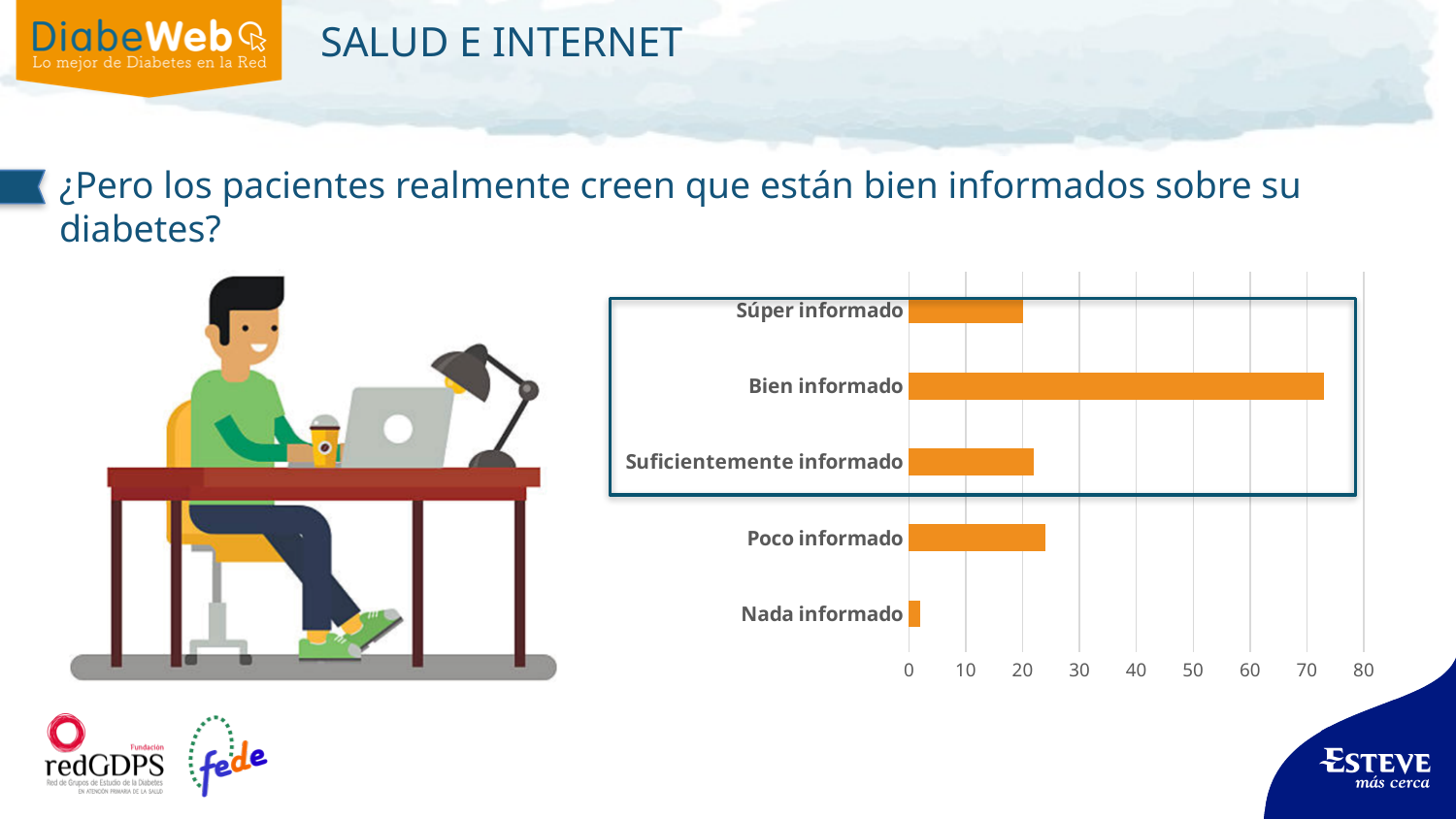
Is the value for Poco informado greater or less than 20? greater Is the value for Suficientemente informado greater or less than 30? less Which category has the lowest value in the chart? Nada informado How many categories are plotted in the chart? 5 Which category has the highest value in the chart? Bien informado Which is larger, the value for Súper informado or the value for Nada informado? Súper informado Which is larger, the value for Bien informado or the value for Poco informado? Bien informado What colour are the bars in the chart? orange What kind of chart is shown on the slide? bar chart Is the value for Nada informado greater or less than 10? less